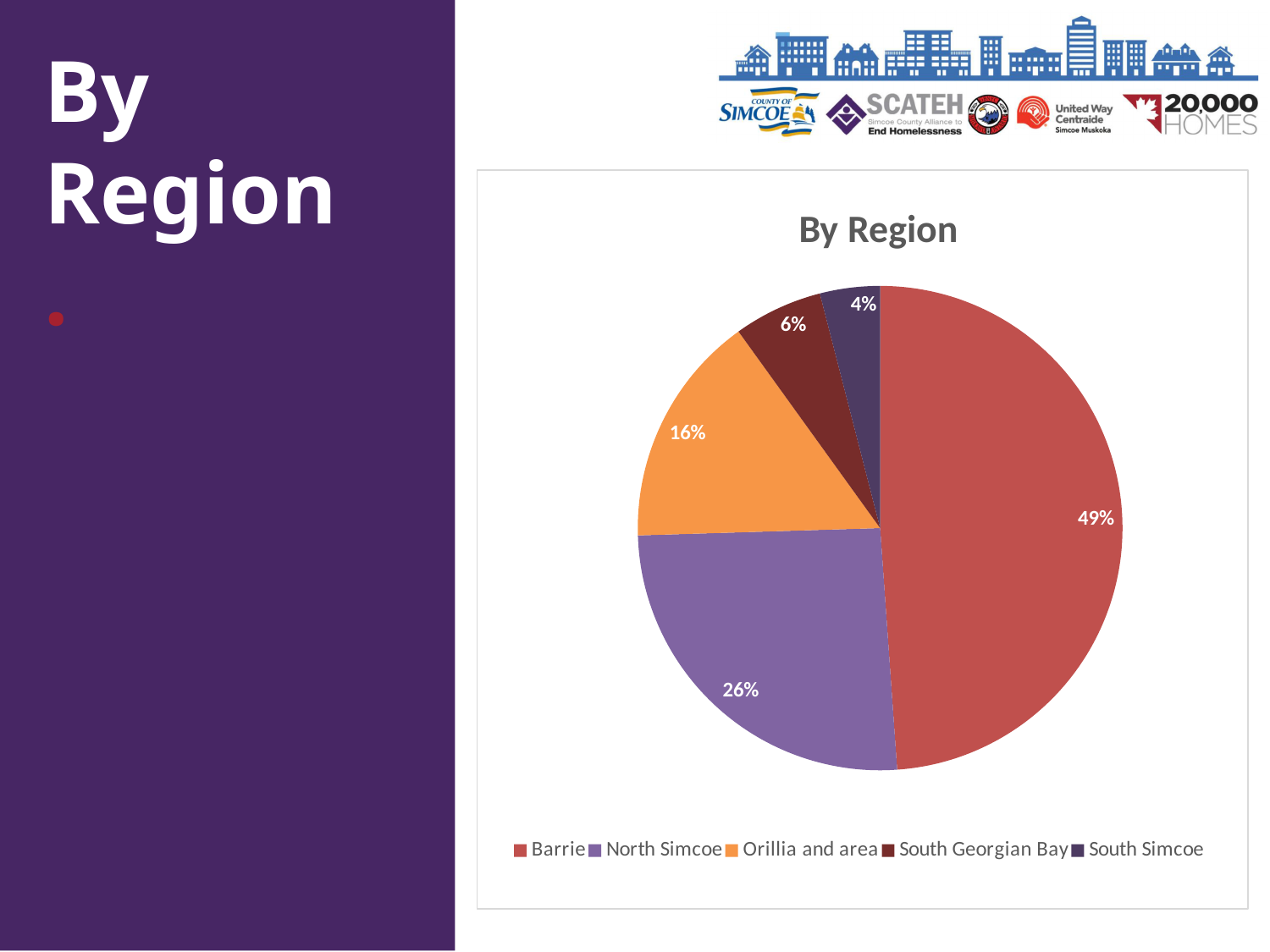
What is the difference in percentage points between Barrie and North Simcoe? 23 Which region has the largest share of the pie? Barrie What share of the pie does North Simcoe account for? 26% What type of chart is shown on the slide? pie chart What percentage is shown for Orillia and area? 16% What percentage is shown for South Georgian Bay? 6% Which has a larger share, Orillia and area or South Georgian Bay? Orillia and area What percentage is shown for South Simcoe? 4% What share of the pie does Barrie account for? 49% Which region has the smallest share of the pie? South Simcoe How many regions are listed in the legend? 5 What is the title of the chart? By Region